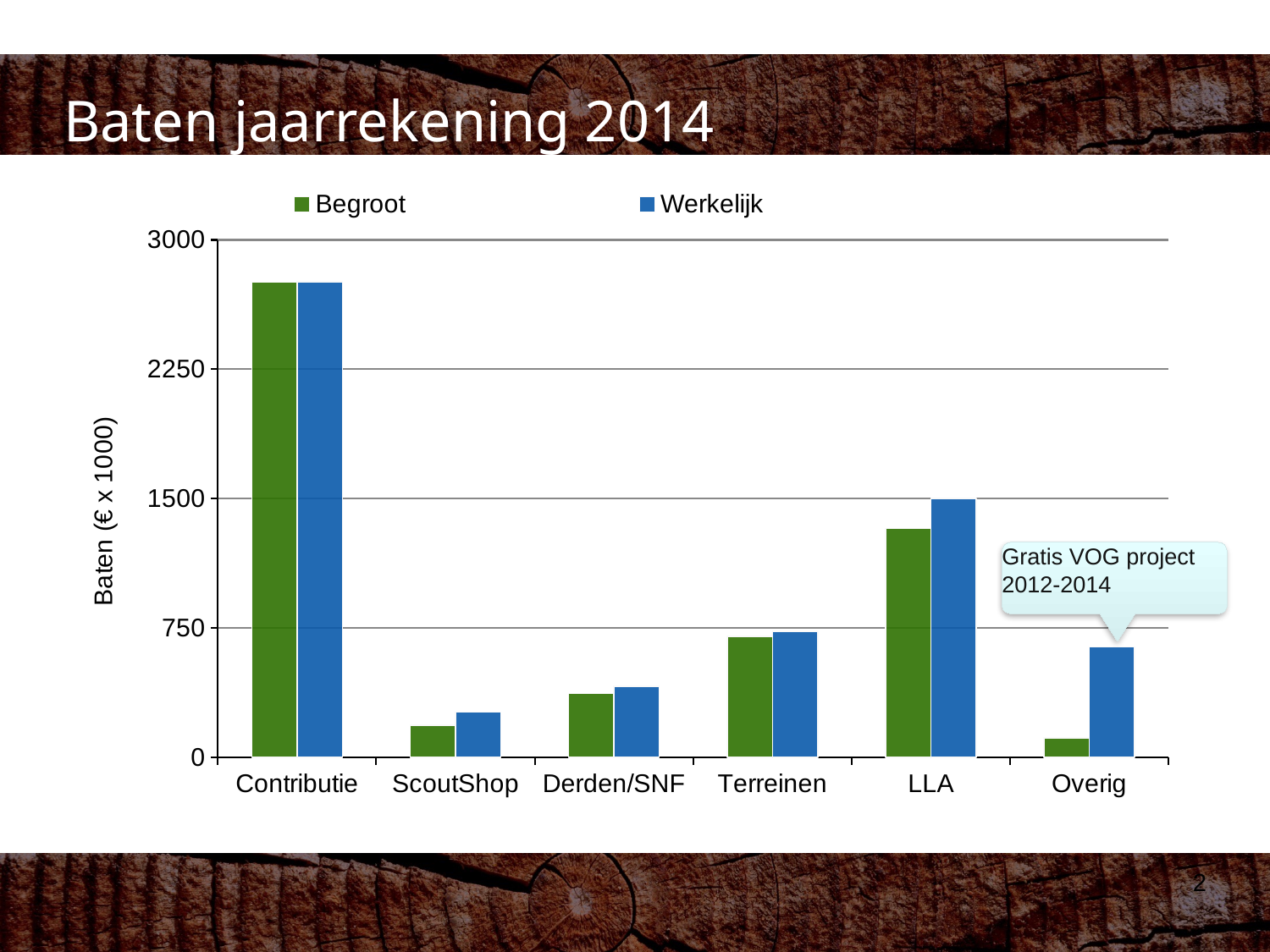
For LLA, which is larger: Begroot or Werkelijk? Werkelijk Is the Werkelijk value for Overig greater or less than 750? less Which category has the lowest Werkelijk value? ScoutShop For Overig, which is larger: Begroot or Werkelijk? Werkelijk How many series does the legend list? 2 Which category has the highest Begroot value? Contributie Is the Begroot value for Contributie greater or less than 2250? greater What kind of chart is shown on the slide? bar chart Which category has the lowest Begroot value? Overig How many categories are shown on the x axis? 6 What is the title of the slide containing the chart? Baten jaarrekening 2014 Is the Begroot value for LLA greater or less than 1500? less